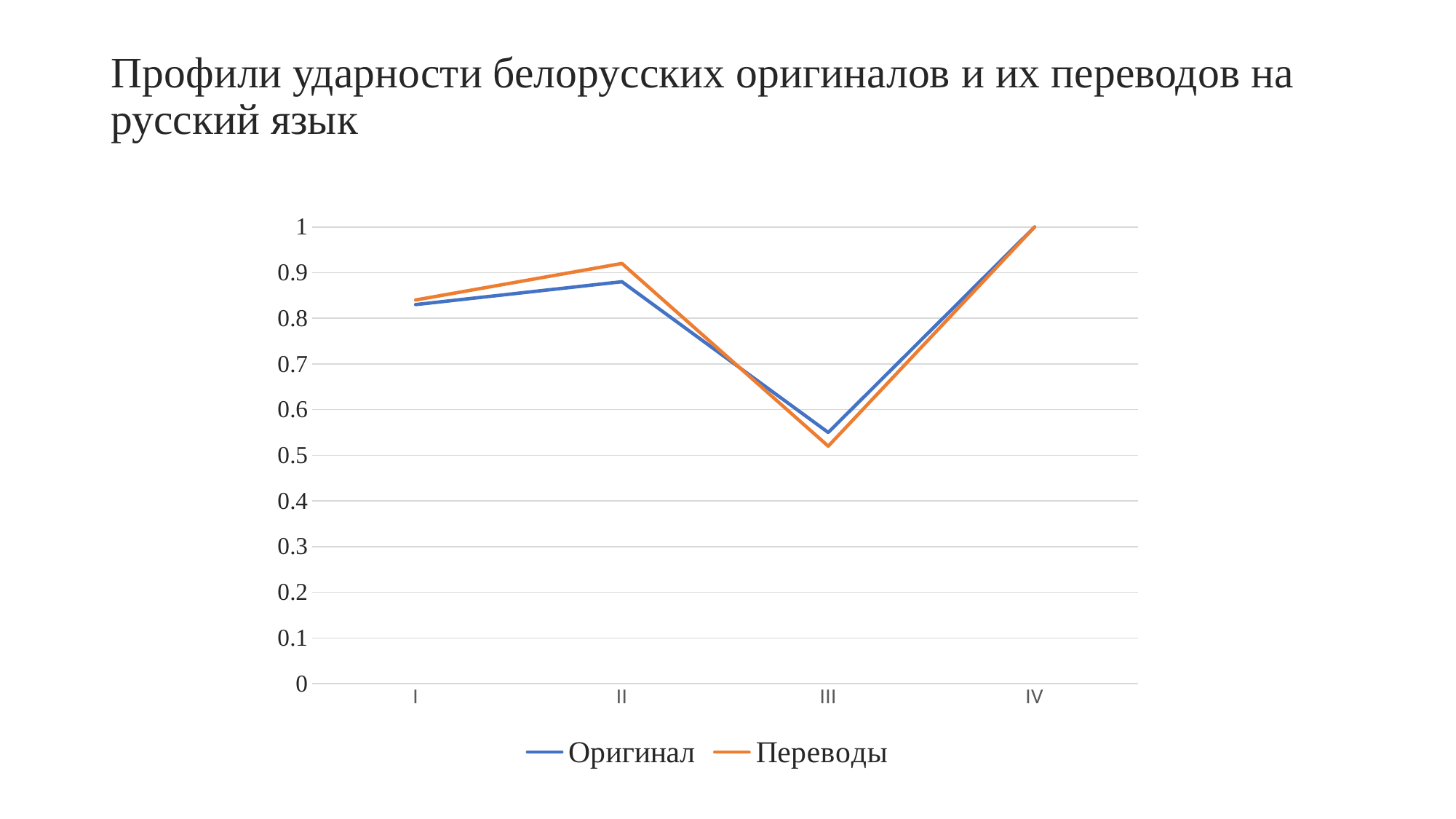
At which category is the Переводы series highest? IV Is the value of the Переводы series at III greater or less than 0.6? less What are the names of the two series in the legend? Оригинал and Переводы At which category is the Оригинал series lowest? III What is the value of the Оригинал series at IV? 1 What is the value of the Переводы series at IV? 1 Do the values of the Оригинал series rise or fall from II to III? fall What kind of chart is shown on the slide? line chart Is the value of the Оригинал series at I greater or less than 0.8? greater At II, which series has the higher value, Оригинал or Переводы? Переводы How many categories are shown on the x axis? 4 How many series does the legend list? 2